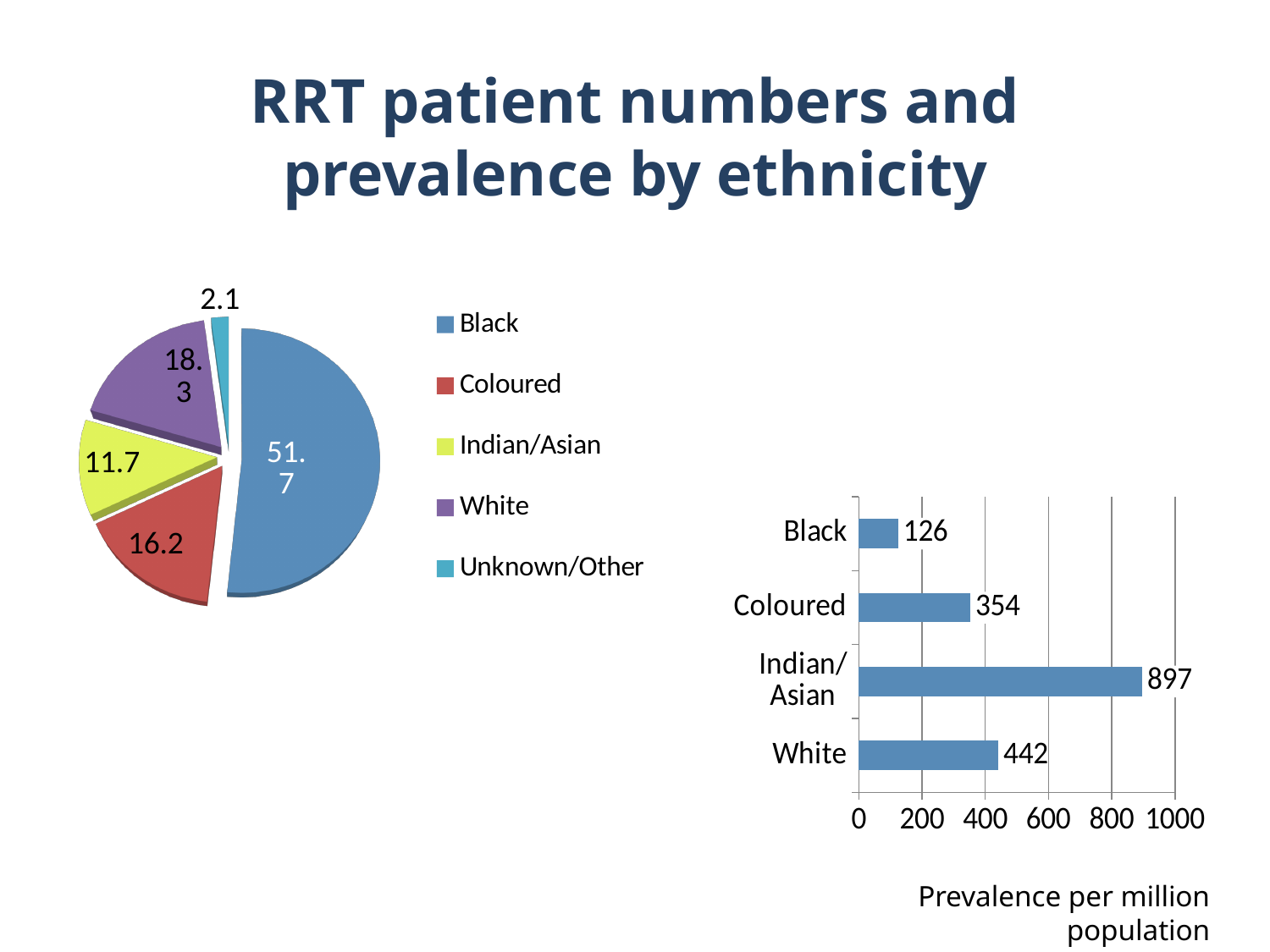
In the bar chart on the right, what is the difference between the values for White and Coloured? 88 In the pie chart on the left, which slice is larger, White or Indian/Asian? White In the pie chart on the left, which category has the largest slice? Black In the bar chart on the right, which ethnicity has the highest prevalence per million population? Indian/Asian In the pie chart on the left, what is the value shown for the Black slice? 51.7 In the bar chart on the right, what is the prevalence per million population for Indian/Asian? 897 How many bars are shown in the bar chart on the right? 4 In the bar chart on the right, what is the prevalence per million population for Black? 126 In the pie chart on the left, which category has the smallest slice? Unknown/Other In the pie chart on the left, what is the value shown for the Coloured slice? 16.2 What kind of chart is the chart on the right of the slide? Bar chart How many categories does the legend of the pie chart on the left list? 5